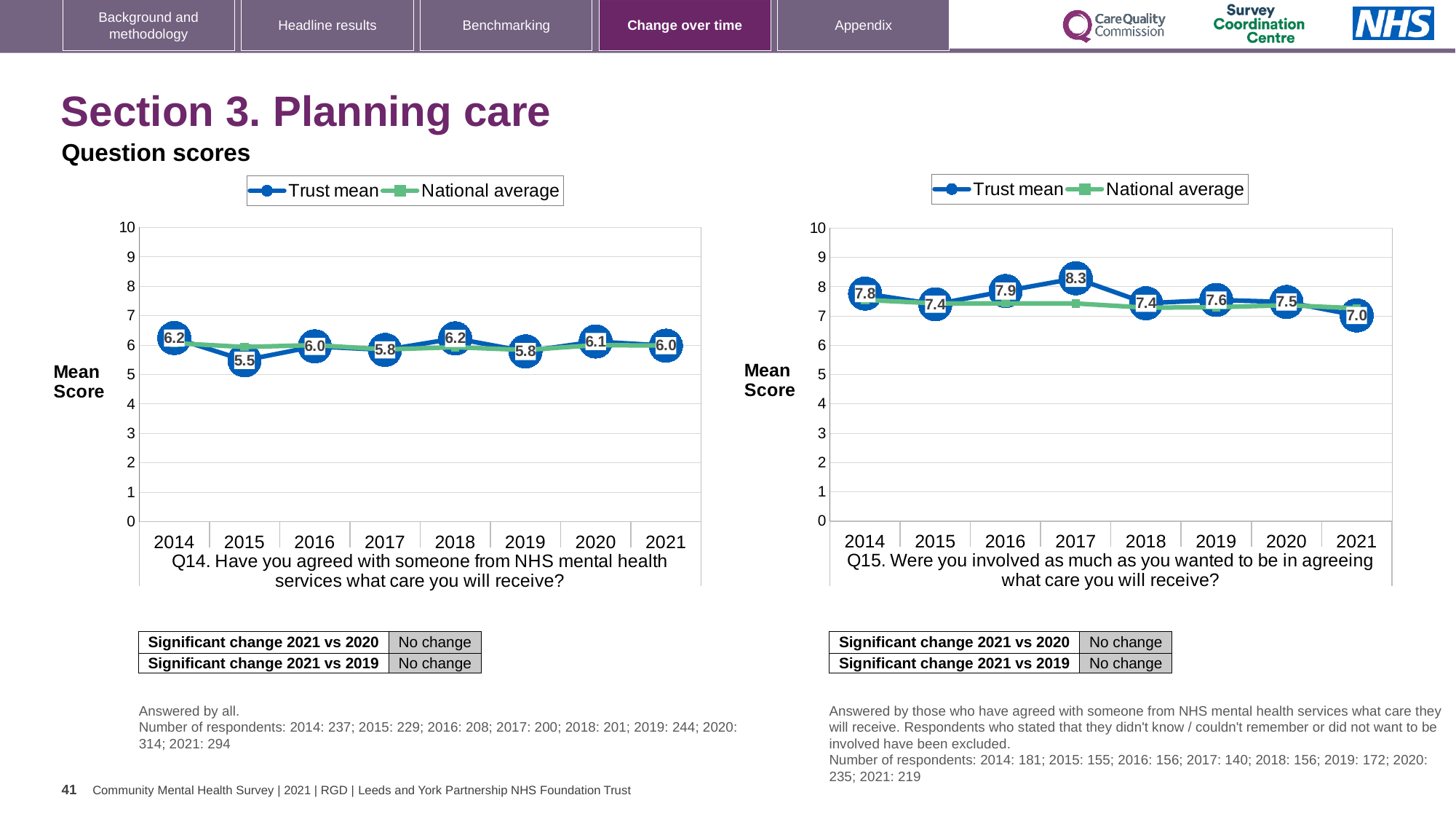
In the Q15 chart on the right, is the Trust mean value for 2017 greater or less than 8? greater In the Q14 chart on the left, is the Trust mean score for 2018 larger than the score for 2019? Yes, 6.2 vs 5.8 In the Q15 chart on the right, what is the difference between the Trust mean scores for 2017 and 2021? 1.3 In the Q15 chart on the right, which year has the highest Trust mean score? 2017 In the Q14 chart on the left, what is the Trust mean score for 2021? 6.0 In the Q15 chart on the right, what is the Trust mean score for 2017? 8.3 How many series does the legend of the Q15 chart on the right list? 2 How many years are plotted on the x axis of the Q14 chart on the left? 8 In the Q15 chart on the right, what is the Trust mean score for 2021? 7.0 In the Q14 chart on the left, which year has the lowest Trust mean score? 2015 In the Q14 chart on the left, what is the Trust mean score for 2015? 5.5 In the Q15 chart on the right, which year has the lowest Trust mean score? 2021